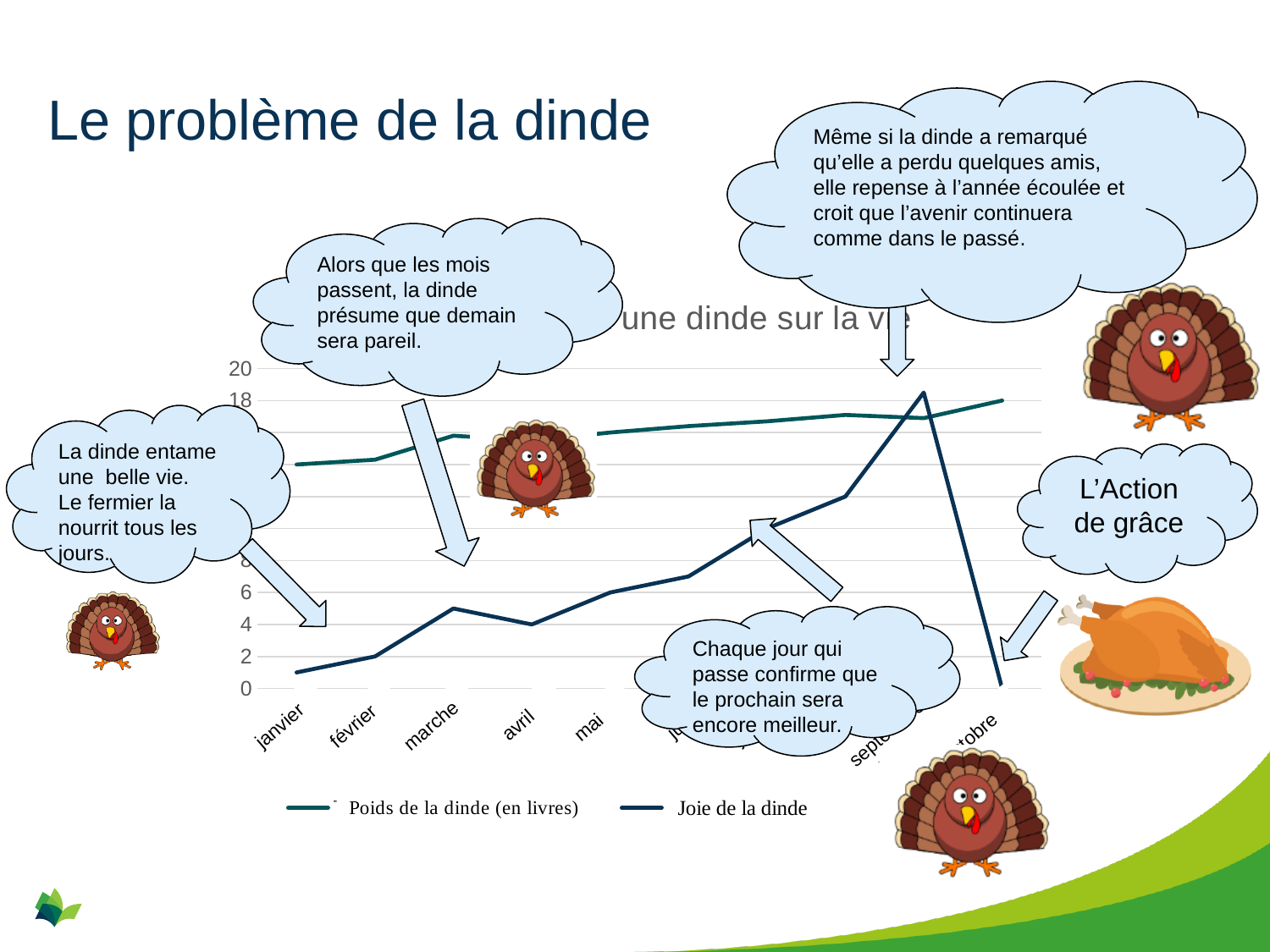
What are the two series named in the chart's legend? Poids de la dinde (en livres) and Joie de la dinde In janvier, which series has the higher value, Poids de la dinde (en livres) or Joie de la dinde? Poids de la dinde (en livres) Is the value of Poids de la dinde (en livres) in janvier greater or less than 12? greater What is the highest value shown on the chart's y axis? 20 Is the value of Joie de la dinde in mai greater or less than 4? greater Is the value of Joie de la dinde in avril greater or less than 6? less What kind of chart is shown on the slide? line chart Does Poids de la dinde (en livres) generally rise or fall from janvier to the end of the x axis? rise How many series does the chart's legend list? 2 In which month does Joie de la dinde reach its highest value? septembre